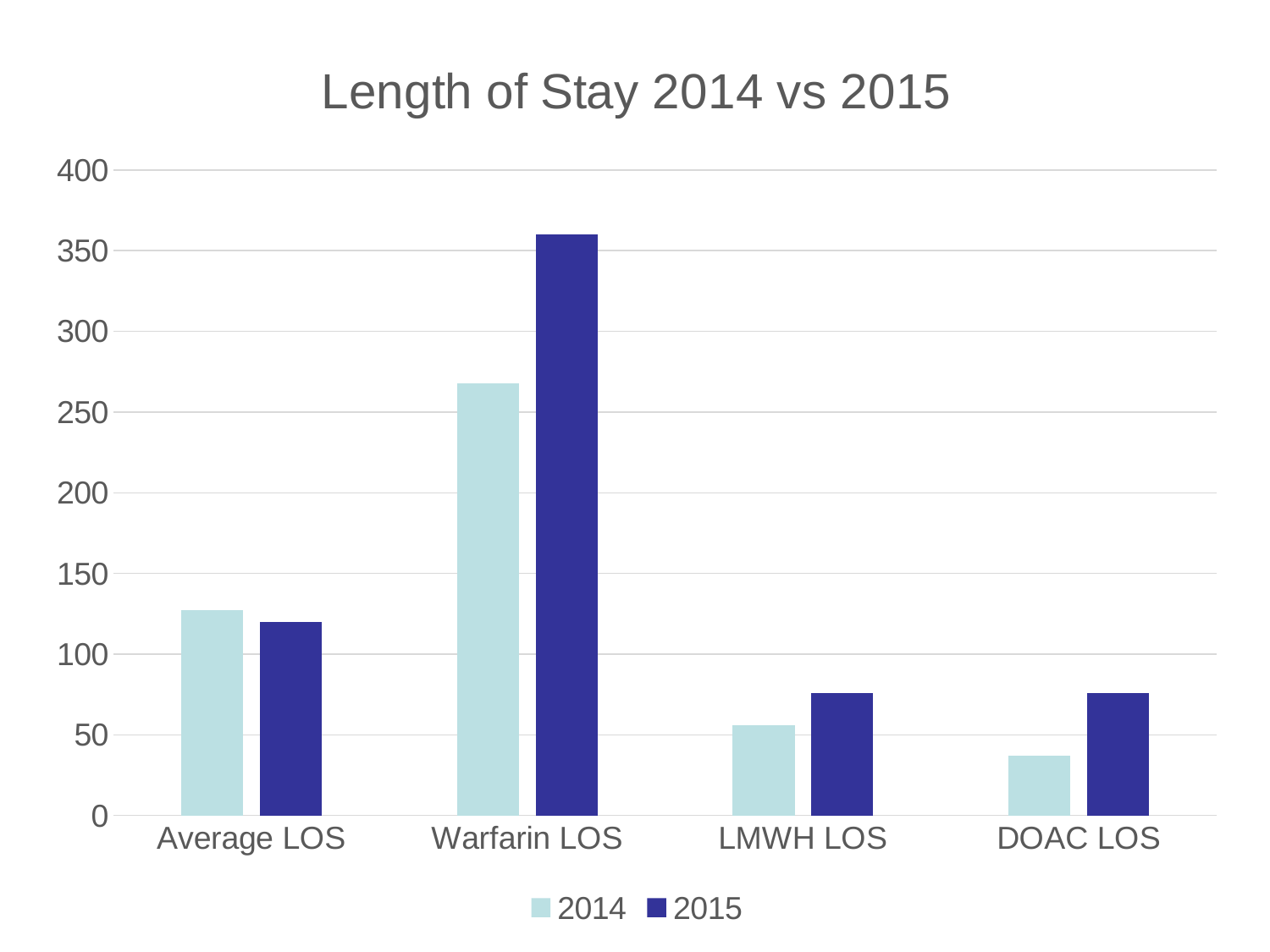
Which category has the highest value for 2015? Warfarin LOS Is the 2014 value for DOAC LOS greater or less than 50? less What is the title of the chart? Length of Stay 2014 vs 2015 How many series does the legend list? 2 Is the 2015 value for Warfarin LOS greater or less than 300? greater Is the 2014 value for Warfarin LOS greater or less than 250? greater Which category has the lowest value for 2014? DOAC LOS For LMWH LOS, which year has the larger value, 2014 or 2015? 2015 What type of chart is shown on the slide? bar chart How many categories are shown on the x axis? 4 For Warfarin LOS, which year has the larger value, 2014 or 2015? 2015